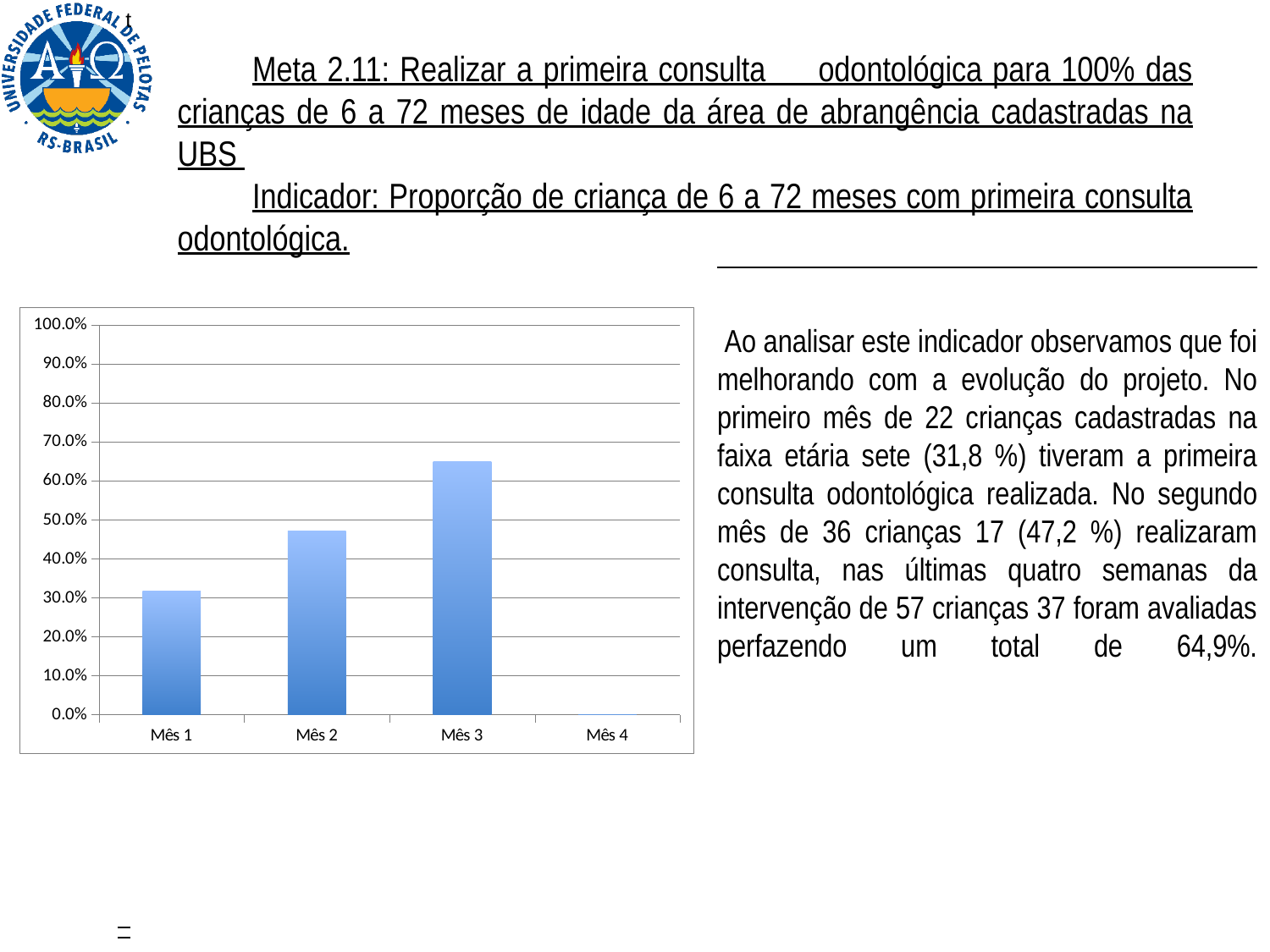
Is the value for Mês 2 greater or less than 40.0%? greater What is the highest tick value shown on the y axis of the chart? 100.0% Is the value for Mês 1 greater or less than 40.0%? less Is the value for Mês 3 greater or less than 60.0%? greater Which category has the lowest value in the chart? Mês 4 What kind of chart is shown on the slide? bar chart Which is larger, the value for Mês 1 or the value for Mês 2? Mês 2 How many categories are shown on the x axis of the chart? 4 Which category has the highest bar in the chart? Mês 3 Do the values rise or fall from Mês 1 to Mês 3? rise